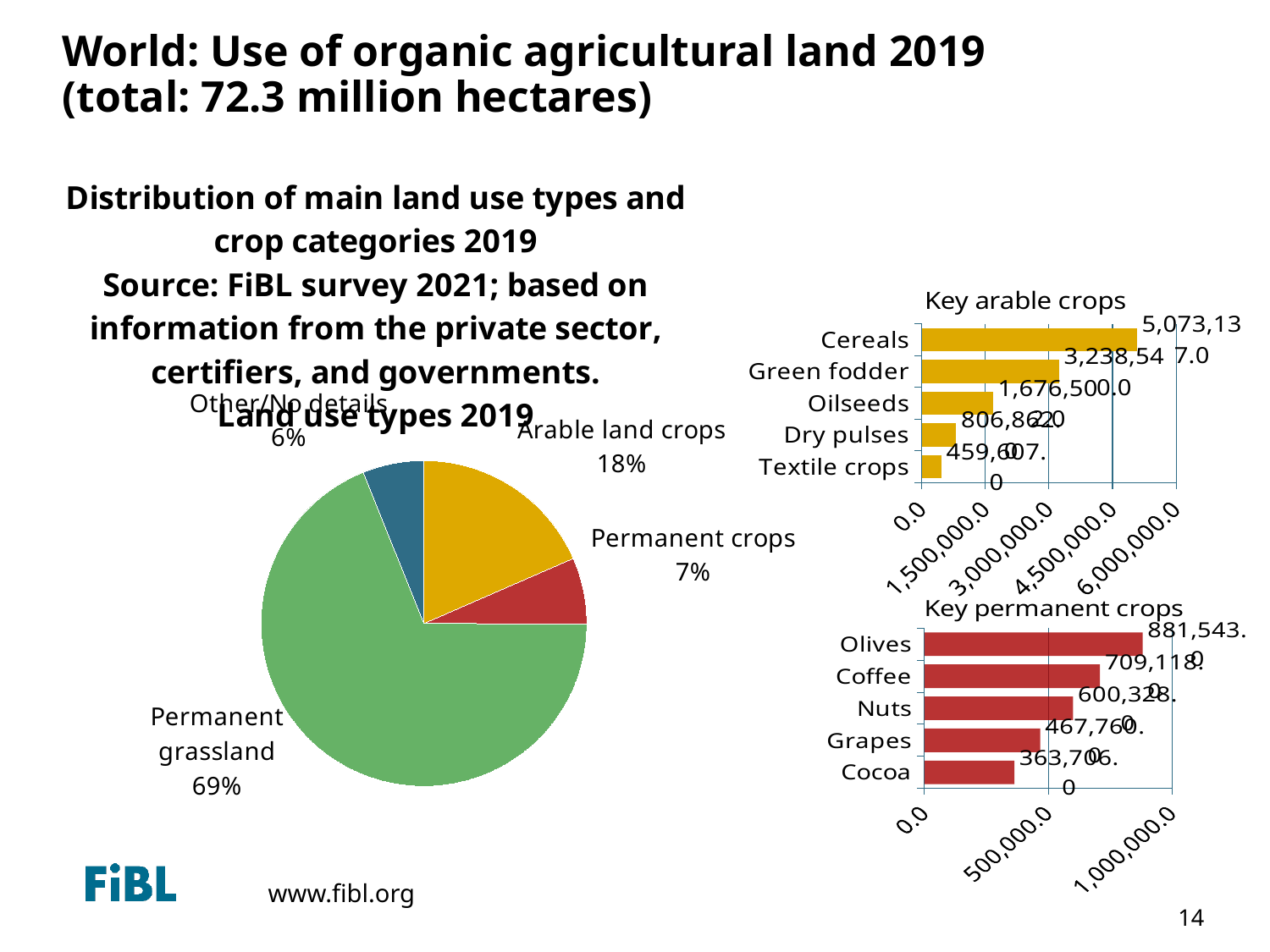
In the Key arable crops chart, is the value for Green fodder greater or less than 3,000,000.0? greater In the Land use types 2019 pie chart, what is the difference in percentage points between Arable land crops and Permanent crops? 11 In the Key permanent crops chart, which crop has the largest value? Olives In the Key arable crops chart, which crop has the smallest value? Textile crops In the Land use types 2019 pie chart, which category has the smallest share? Other/No details In the Key permanent crops chart, is the value for Cocoa greater or less than 500,000.0? less In the Land use types 2019 pie chart, how many slices are there? 4 What kind of chart is the Key permanent crops chart? Bar chart In the Key arable crops chart, which crop has the largest value? Cereals In the Key arable crops chart, what is the value for Oilseeds? 1,676,502.0 In the Land use types 2019 pie chart, what share is Arable land crops? 18% In the Land use types 2019 pie chart, what share is Permanent grassland? 69%